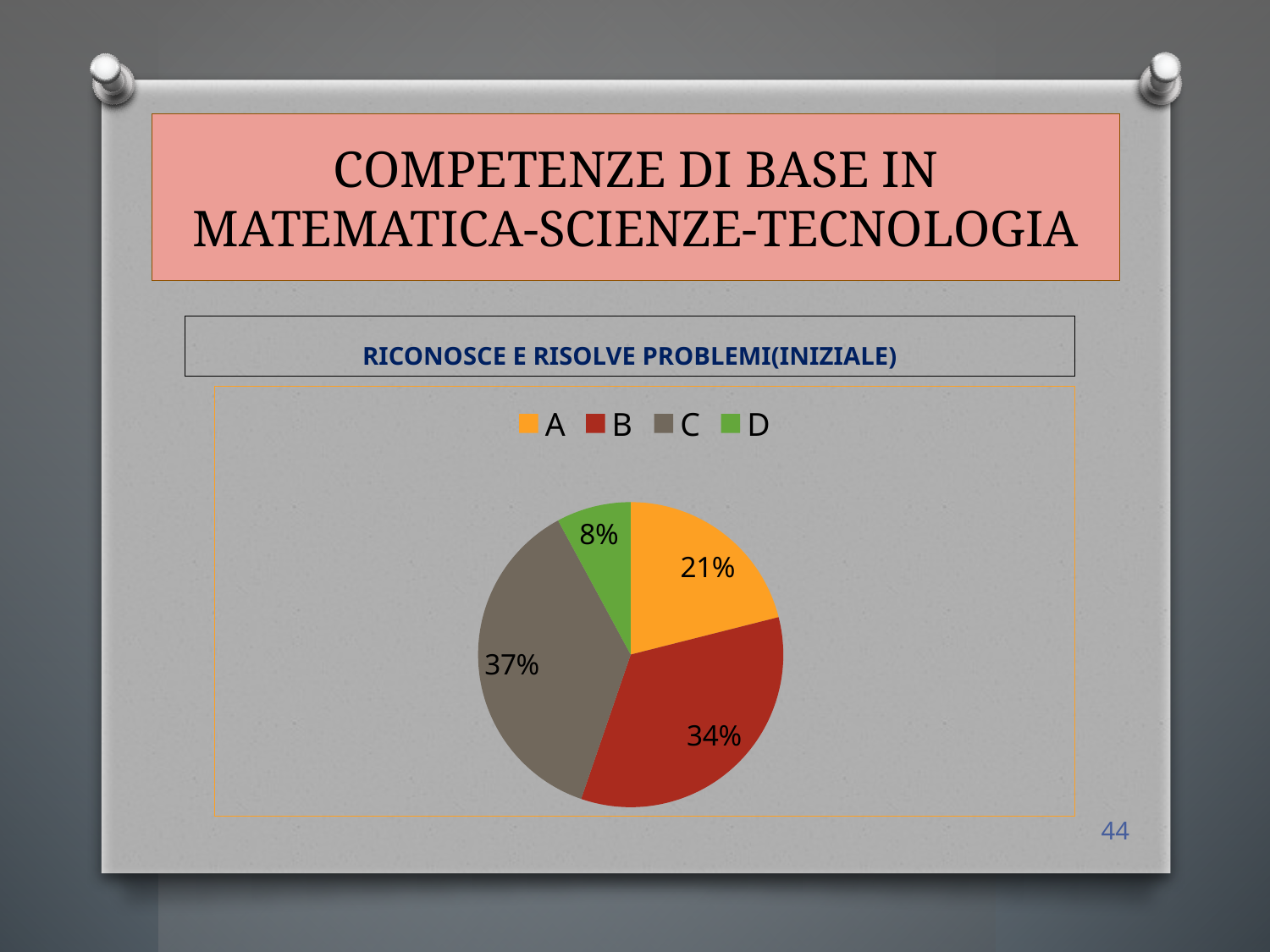
What colour is the slice for category D? green Which is larger, the share for A or the share for B? B What is the share for category B? 34% What kind of chart is shown on the slide? pie chart Which category has the smallest slice of the pie? D What is the share for category C? 37% Which category has the largest slice of the pie? C What is the share for category A? 21% How many categories does the legend list? 4 What is the share for category D? 8% What is the difference in percentage points between category A and category D? 13 What is the difference in percentage points between category C and category B? 3